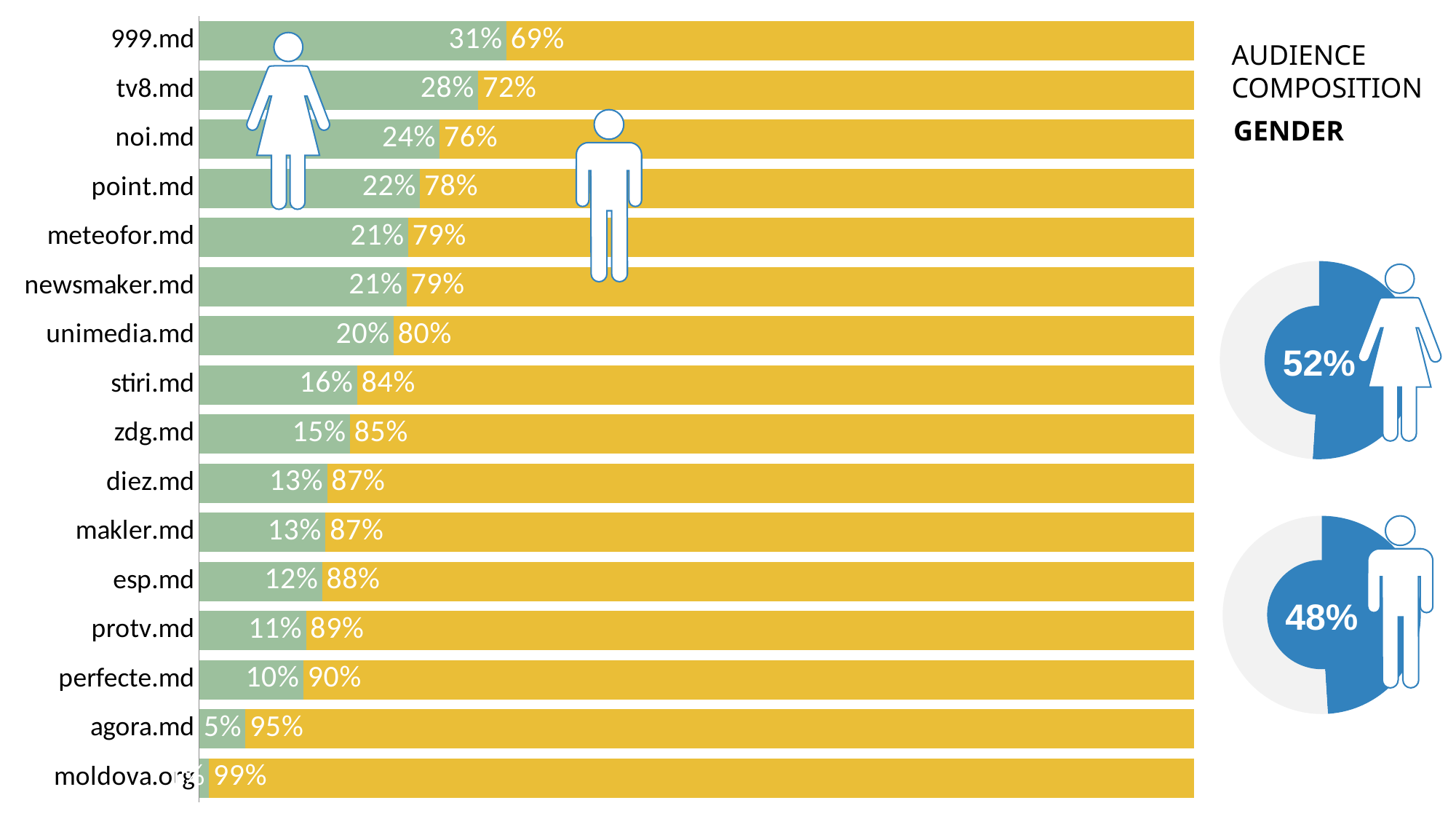
Which website has the largest green segment? 999.md What is the value of the green segment for agora.md? 5% What is the total of the green and yellow segments for zdg.md? 100% What is the value of the green segment for 999.md? 31% What is the value of the yellow segment for unimedia.md? 80% Which has a larger green segment, noi.md or stiri.md? noi.md How many websites are listed in the bar chart? 16 What is the value of the yellow segment for moldova.org? 99% In the circle charts on the right, what percentage is shown next to the female icon? 52% Which website has the largest yellow segment? moldova.org What is the difference between the green segment values of 999.md and tv8.md? 3% What type of chart is used to show the audience composition by website? stacked bar chart